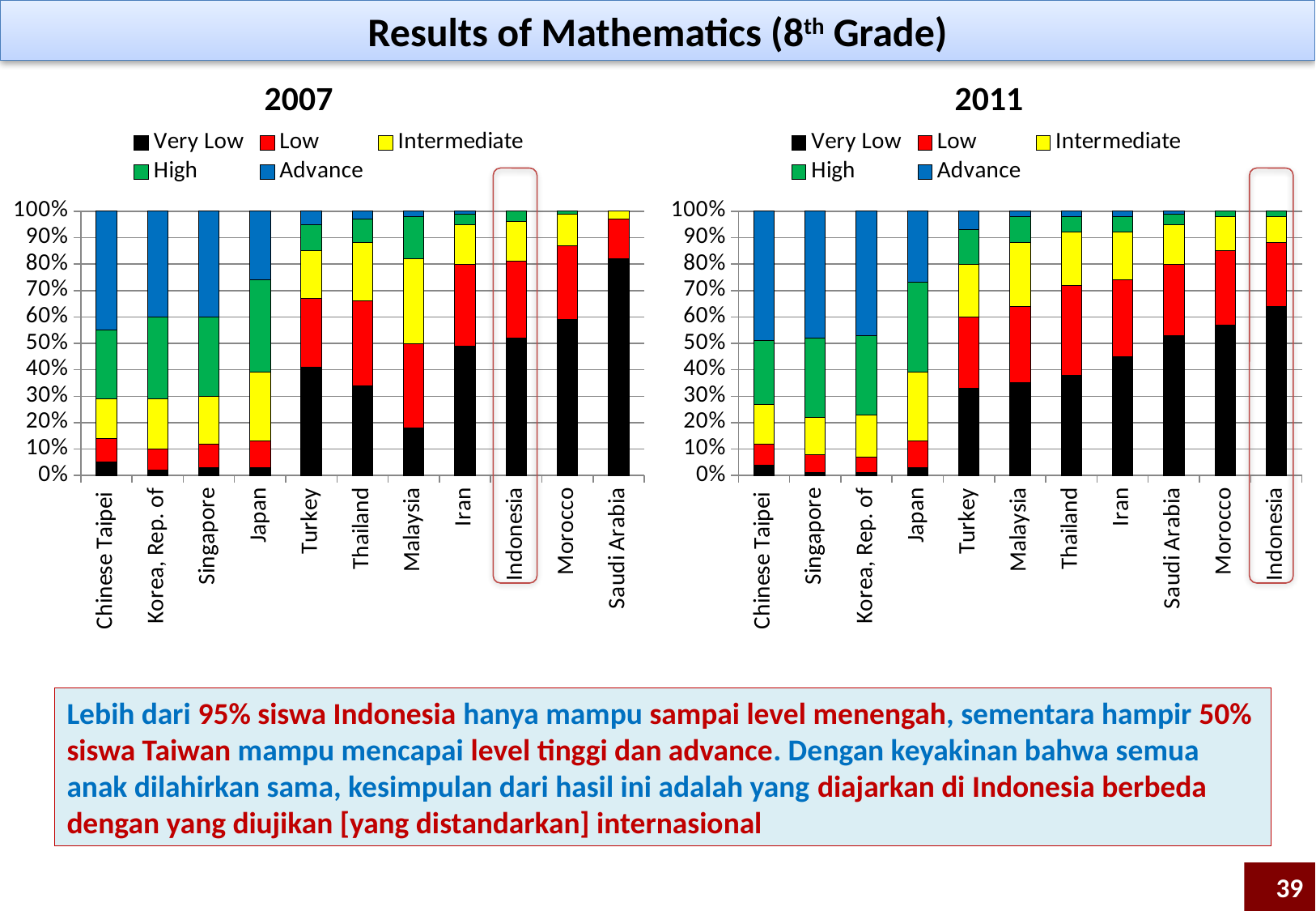
How many countries are shown on the x axis of the 2011 chart? 11 How many series does the legend of the 2011 chart list? 5 In the 2007 chart, which has the larger Very Low share, Turkey or Thailand? Turkey What kind of chart is the 2007 chart? stacked bar chart In the 2011 chart, which country has the highest Very Low share? Indonesia In the 2011 chart, is the Very Low share for Indonesia greater or less than 50%? greater Which country is highlighted with a red outline in both charts? Indonesia In the 2011 chart, which has the larger Very Low share, Morocco or Turkey? Morocco In the 2007 chart, is the Very Low share for Saudi Arabia greater or less than 50%? greater In the 2007 chart, is the Very Low share for Chinese Taipei greater or less than 10%? less In the 2007 chart, which country has the highest Very Low share? Saudi Arabia How many countries are shown on the x axis of the 2007 chart? 11